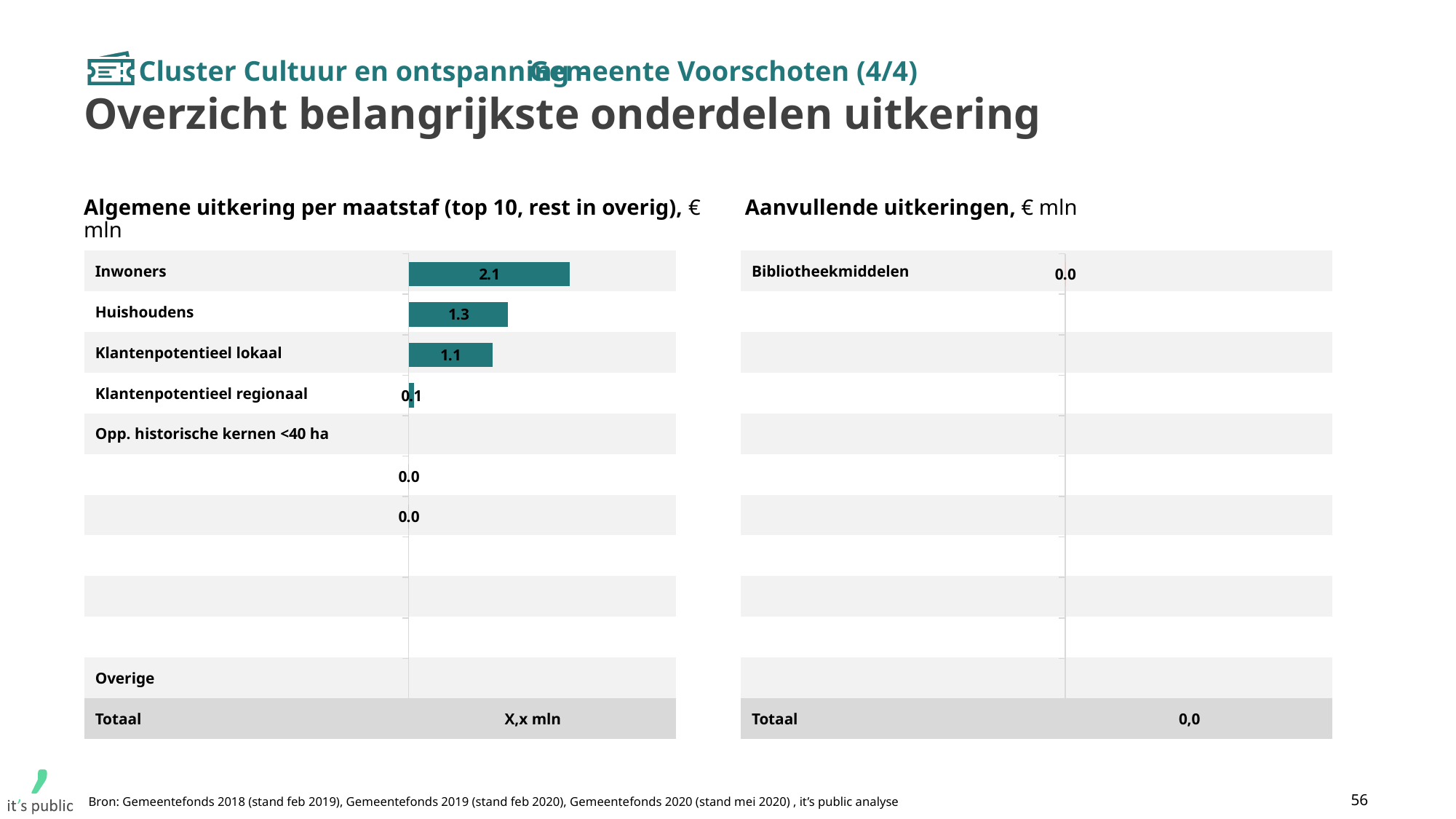
In the left chart 'Algemene uitkering per maatstaf', what is the value for Huishoudens? 1.3 What kind of chart is the left chart 'Algemene uitkering per maatstaf'? Bar chart In the left chart 'Algemene uitkering per maatstaf', what is the difference between Inwoners and Huishoudens? 0.8 In the right chart 'Aanvullende uitkeringen', what is the value shown in the Totaal row? 0,0 In the left chart 'Algemene uitkering per maatstaf', what is the difference between Huishoudens and Klantenpotentieel lokaal? 0.2 What unit is stated in the title of the right chart 'Aanvullende uitkeringen'? € mln In the left chart 'Algemene uitkering per maatstaf', what is the value for Klantenpotentieel regionaal? 0.1 In the right chart 'Aanvullende uitkeringen', what is the value for Bibliotheekmiddelen? 0.0 In the left chart 'Algemene uitkering per maatstaf', which is larger: Klantenpotentieel lokaal or Klantenpotentieel regionaal? Klantenpotentieel lokaal In the left chart 'Algemene uitkering per maatstaf', what is the value for Klantenpotentieel lokaal? 1.1 In the left chart 'Algemene uitkering per maatstaf', what is the value for Inwoners? 2.1 In the left chart 'Algemene uitkering per maatstaf', which category has the highest value? Inwoners